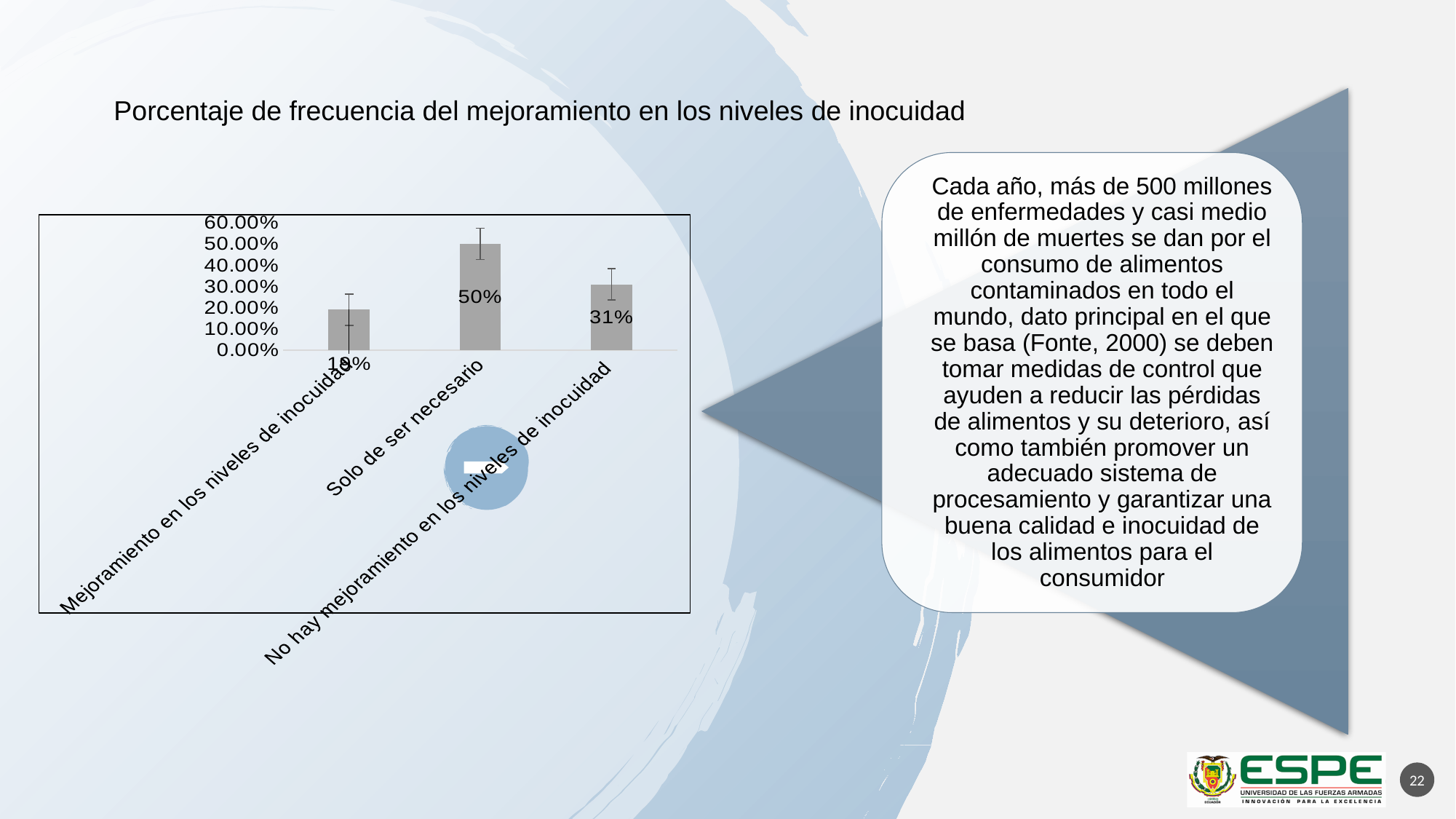
Is the value for "Mejoramiento en los niveles de inocuidad" greater or less than 30.00%? less What is the highest tick value shown on the vertical axis of the chart? 60.00% Which is larger, the value for "No hay mejoramiento en los niveles de inocuidad" or the value for "Mejoramiento en los niveles de inocuidad"? No hay mejoramiento en los niveles de inocuidad What is the value for "Solo de ser necesario"? 50% Is the value for "Solo de ser necesario" greater or less than 40.00%? greater Which category has the lowest value? Mejoramiento en los niveles de inocuidad What is the difference between the values for "Solo de ser necesario" and "No hay mejoramiento en los niveles de inocuidad"? 19% What is the title shown above the chart on the slide? Porcentaje de frecuencia del mejoramiento en los niveles de inocuidad How many categories are plotted in the chart? 3 What kind of chart is shown on the slide? Bar chart Which category has the highest value? Solo de ser necesario What is the value for "No hay mejoramiento en los niveles de inocuidad"? 31%